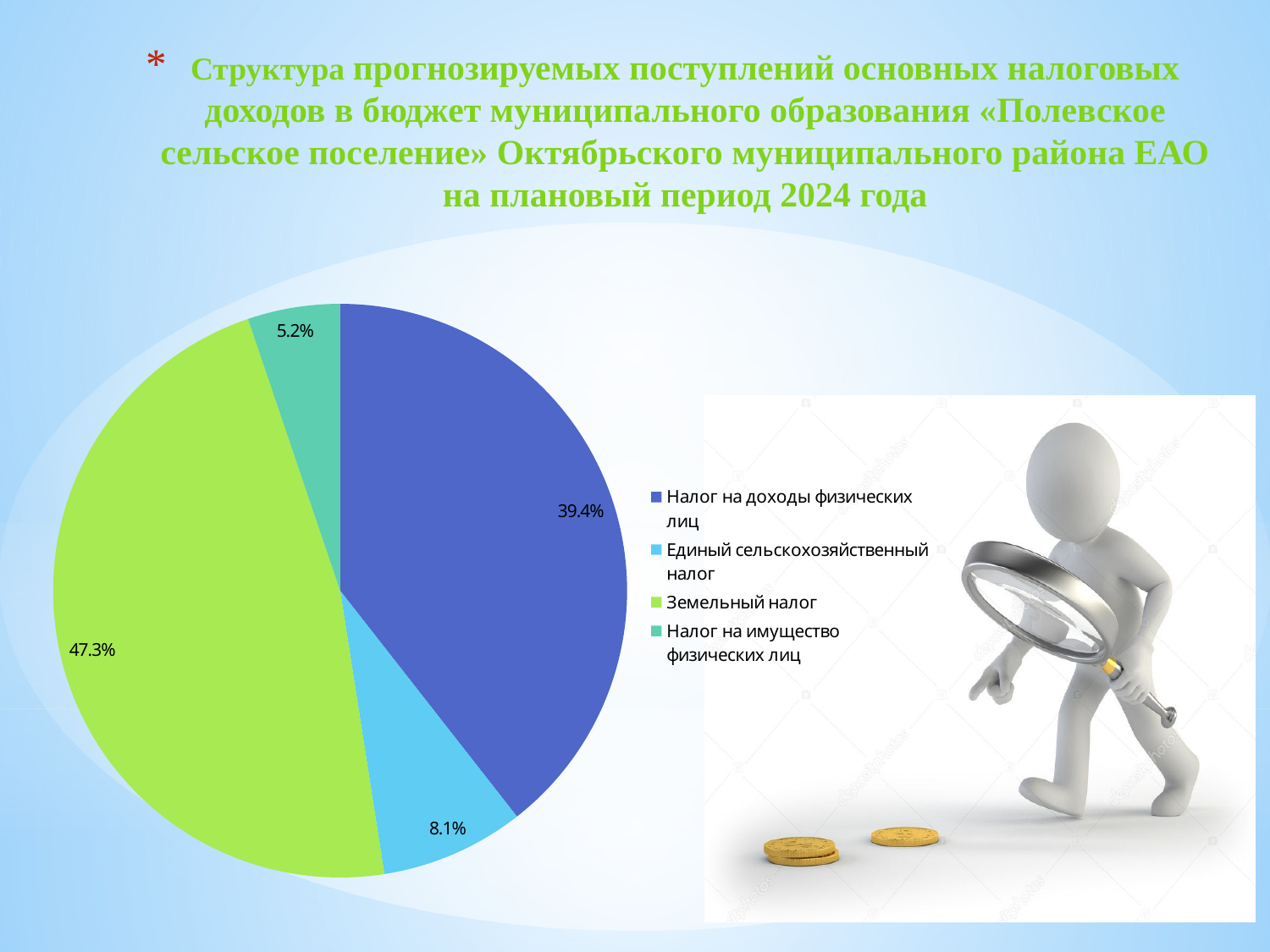
What kind of chart is shown on the slide? pie chart Which category has the largest slice of the pie? Земельный налог What is the value shown for Налог на имущество физических лиц? 5.2% What is the value shown for Единый сельскохозяйственный налог? 8.1% What is the value shown for Налог на доходы физических лиц? 39.4% What is the difference between the shares of Земельный налог and Налог на доходы физических лиц? 7.9% How many entries does the legend list? 4 How many slices does the pie chart have? 4 What share of the pie does Земельный налог have? 47.3% What colour is the slice for Налог на доходы физических лиц? blue Which category has the smallest slice of the pie? Налог на имущество физических лиц Which is larger: the share of Единый сельскохозяйственный налог or the share of Налог на имущество физических лиц? Единый сельскохозяйственный налог